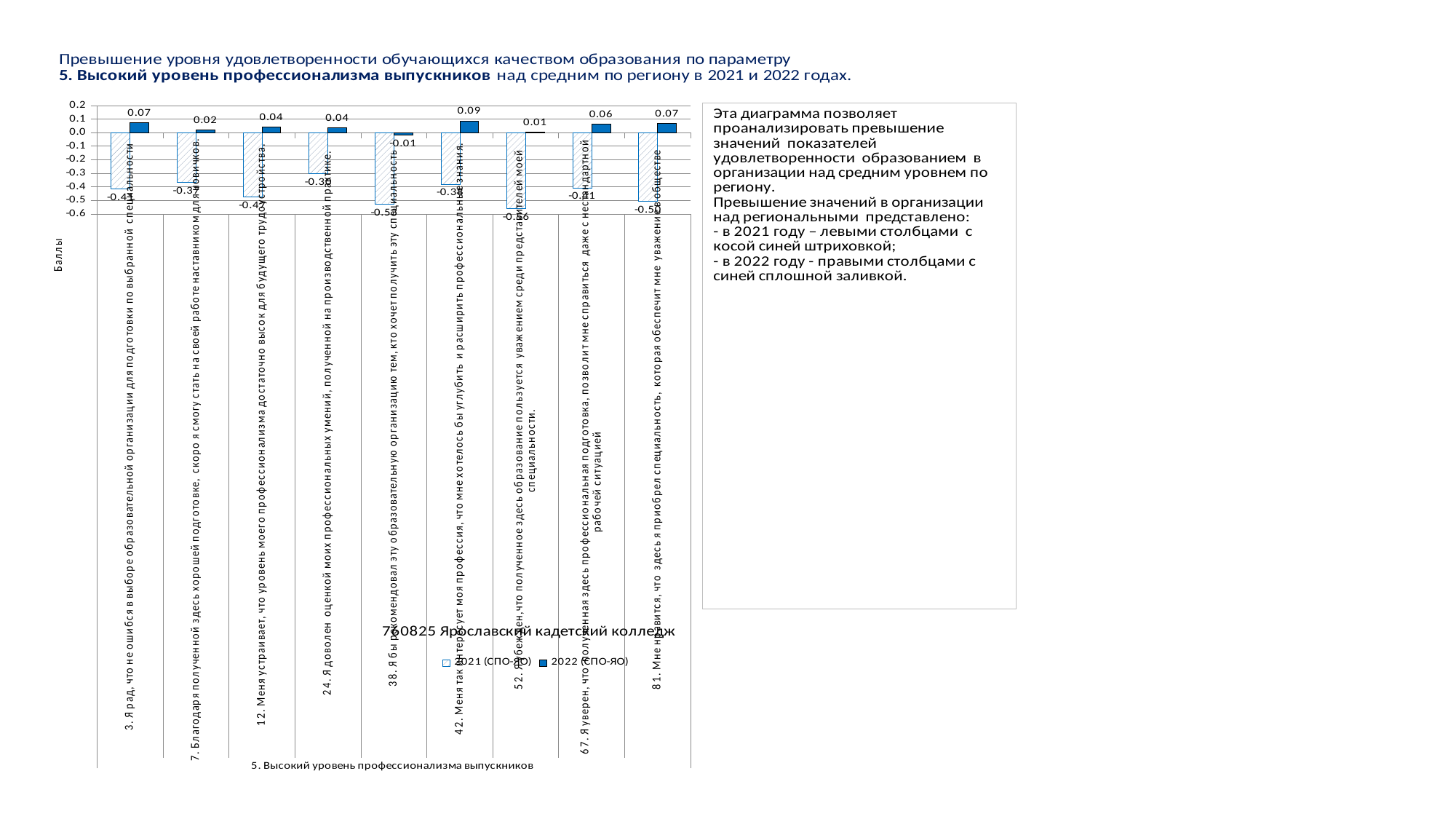
Which statement has the highest 2022 (СПО-ЯО) value? 42. Меня так интересует моя профессия... What are the two entries in the chart legend? 2021 (СПО-ЯО) and 2022 (СПО-ЯО) What is the 2021 (СПО-ЯО) value for statement 52 ("Я убежден, что полученное здесь образование...")? -0.56 Is the 2021 (СПО-ЯО) value for statement 12 greater or less than -0.4? less What kind of chart is shown on the slide? bar chart Which statement has the lowest 2021 (СПО-ЯО) value? 52. Я убежден, что полученное здесь образование... How many series does the chart legend list? 2 Which statement has the lowest 2022 (СПО-ЯО) value? 38. Я бы рекомендовал эту образовательную организацию... Which is larger: the 2022 (СПО-ЯО) value for statement 3 or for statement 7? statement 3 (0.07) What is the difference between the 2022 and 2021 values for statement 3 ("Я рад, что не ошибся в выборе...")? 0.48 How many statements (categories) are plotted on the x axis of the chart? 9 What is the 2022 (СПО-ЯО) value for statement 42 ("Меня так интересует моя профессия...")? 0.09